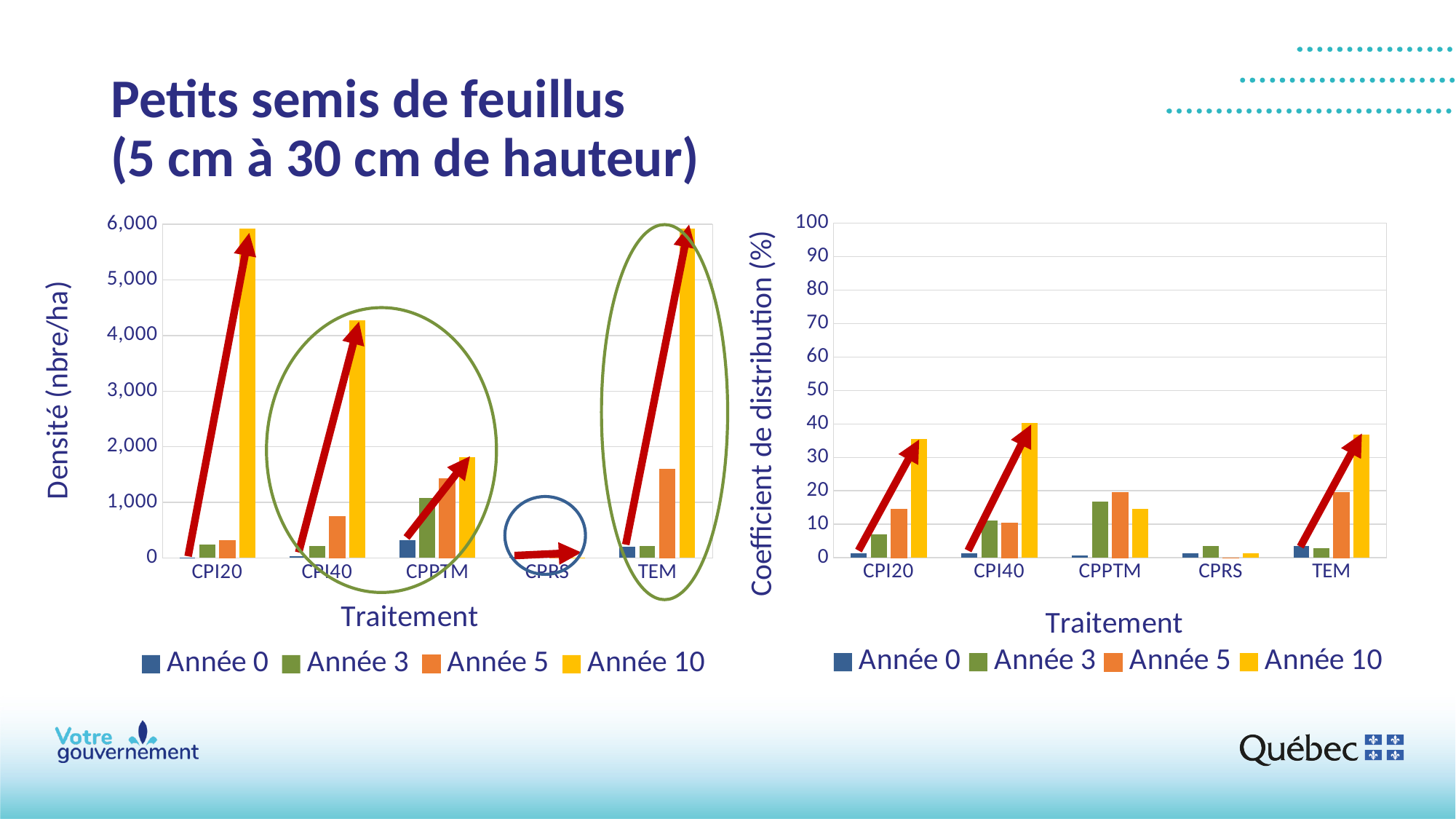
In the left chart (Densité), is the Année 10 value for CPI40 greater or less than 4,000? greater How many treatment categories are shown on the x axis of the left chart (Densité)? 5 In the left chart (Densité), is the Année 5 value for TEM greater or less than 1,000? greater In the left chart (Densité), is the Année 10 value for CPPTM greater or less than 2,000? less What kind of chart is the left chart (Densité)? bar chart In the left chart (Densité), which treatment has the lowest Année 10 value? CPRS How many series does the legend of the right chart (Coefficient de distribution) list? 4 In the right chart (Coefficient de distribution), which treatment has the highest Année 3 value? CPPTM What is the y-axis label of the right chart? Coefficient de distribution (%) In the left chart (Densité), which is larger for Année 10: CPI40 or CPPTM? CPI40 In the right chart (Coefficient de distribution), which is larger for CPPTM: Année 5 or Année 10? Année 5